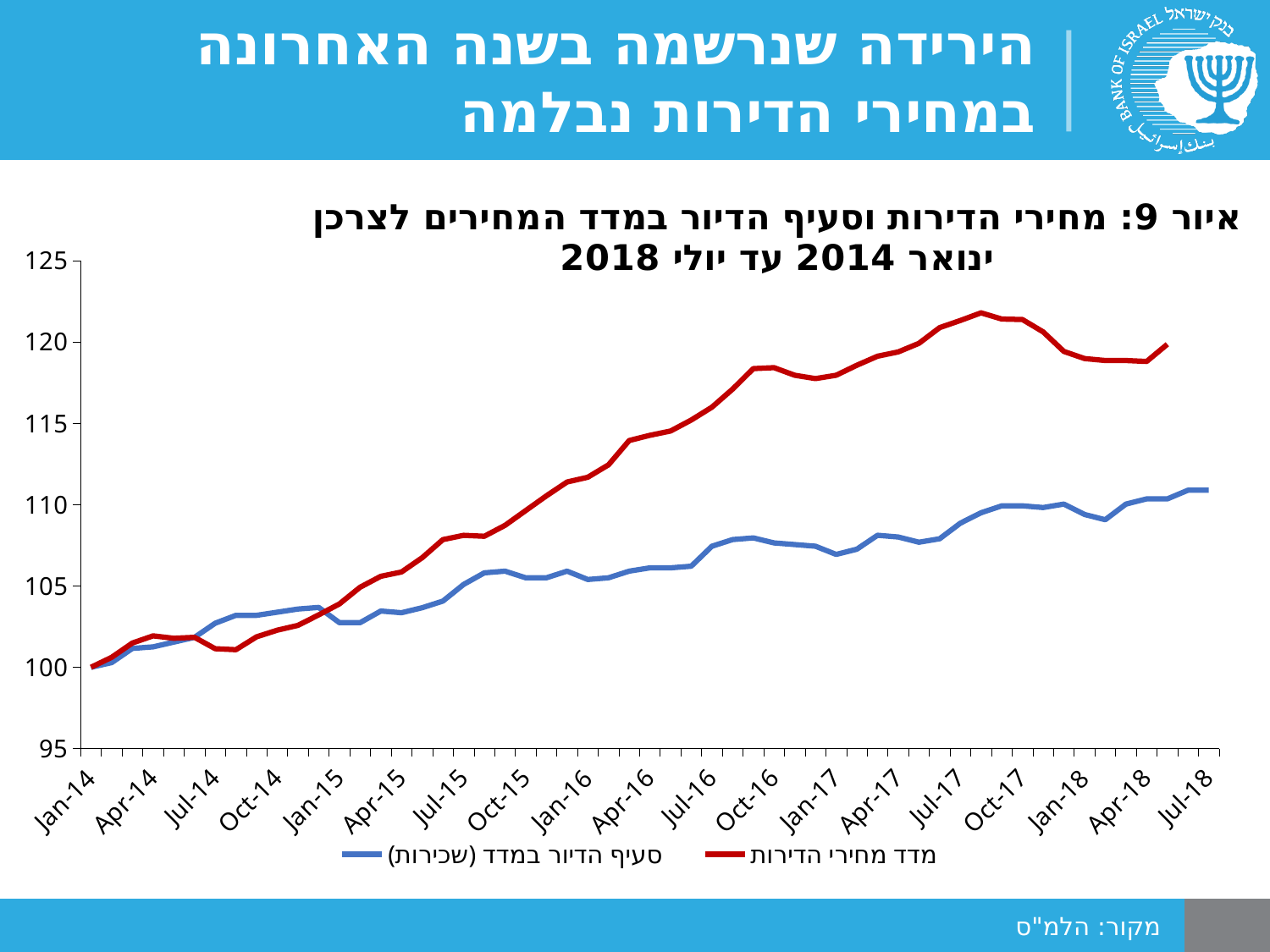
What kind of chart is shown on the slide? line chart Which series reaches the highest value on the chart? מדד מחירי הדירות How many series does the legend list? 2 Is the value of סעיף הדיור במדד (שכירות) at Jan-17 greater or less than 110? less What is the value of סעיף הדיור במדד (שכירות) at Jan-14? 100 Is the value of מדד מחירי הדירות at Oct-17 greater or less than 120? greater What colour is the line for סעיף הדיור במדד (שכירות)? blue Does the value of מדד מחירי הדירות rise or fall overall from Jan-14 to Jul-18? rise Is the value of מדד מחירי הדירות at Jan-15 greater or less than 105? less What is the value of מדד מחירי הדירות at Jan-14? 100 At Jan-16, which series has the higher value: מדד מחירי הדירות or סעיף הדיור במדד (שכירות)? מדד מחירי הדירות